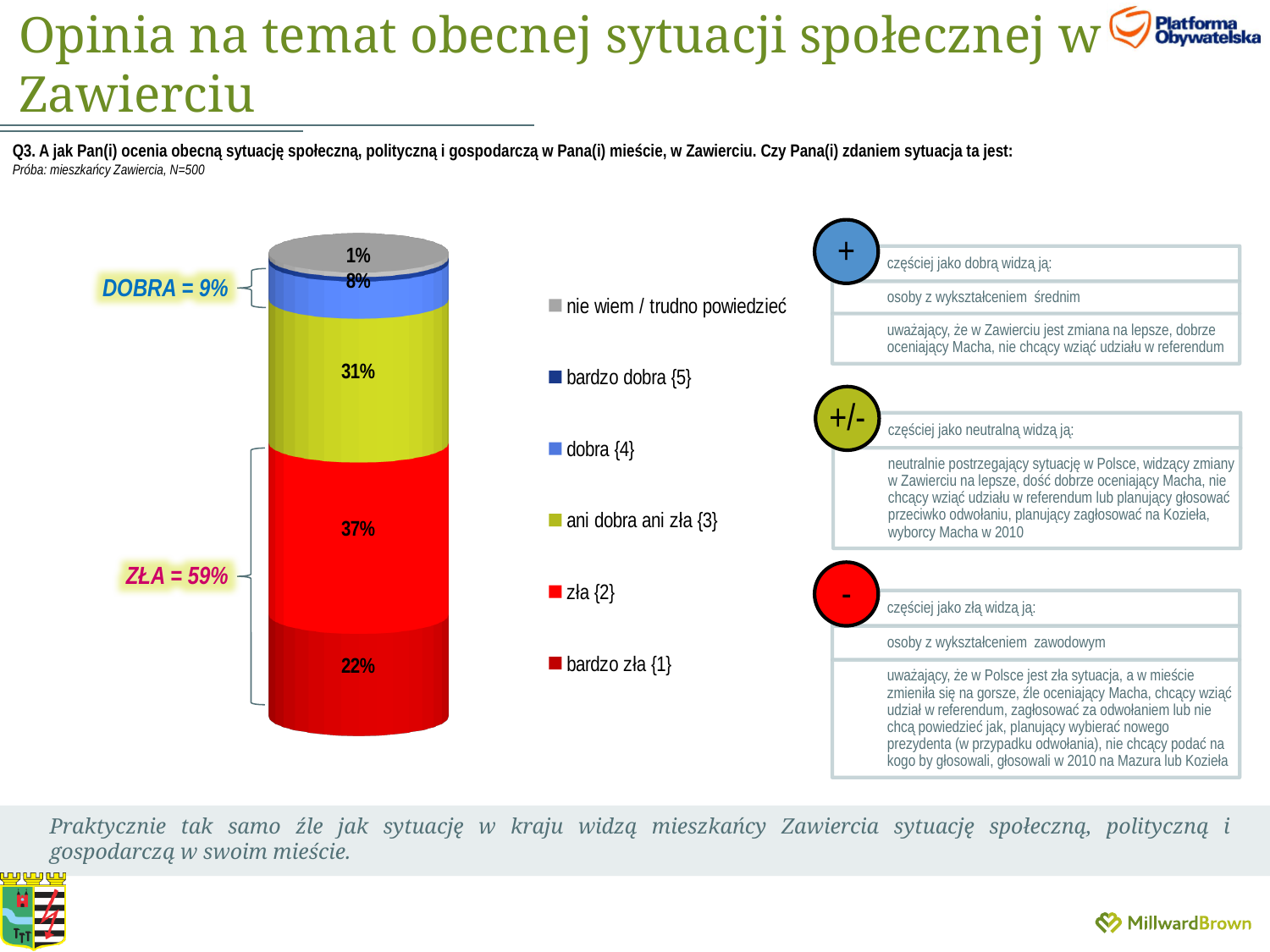
What percentage of respondents answered "nie wiem / trudno powiedzieć"? 1% How many response categories does the legend list? 6 What percentage of respondents answered "dobra {4}"? 8% What combined value is shown for the "DOBRA" annotation next to the bar? 9% What is the difference between the share for "zła {2}" and the share for "bardzo zła {1}"? 15% What percentage of respondents answered "ani dobra ani zła {3}"? 31% Which response category has the largest share in the bar? zła {2} What percentage of respondents rated the situation as "bardzo zła {1}"? 22% What is the combined share of "zła {2}" and "bardzo zła {1}"? 59% Which is larger: the share for "ani dobra ani zła {3}" or the share for "bardzo zła {1}"? ani dobra ani zła {3} What kind of chart is shown on the slide? stacked bar chart What percentage of respondents rated the situation as "zła {2}"? 37%